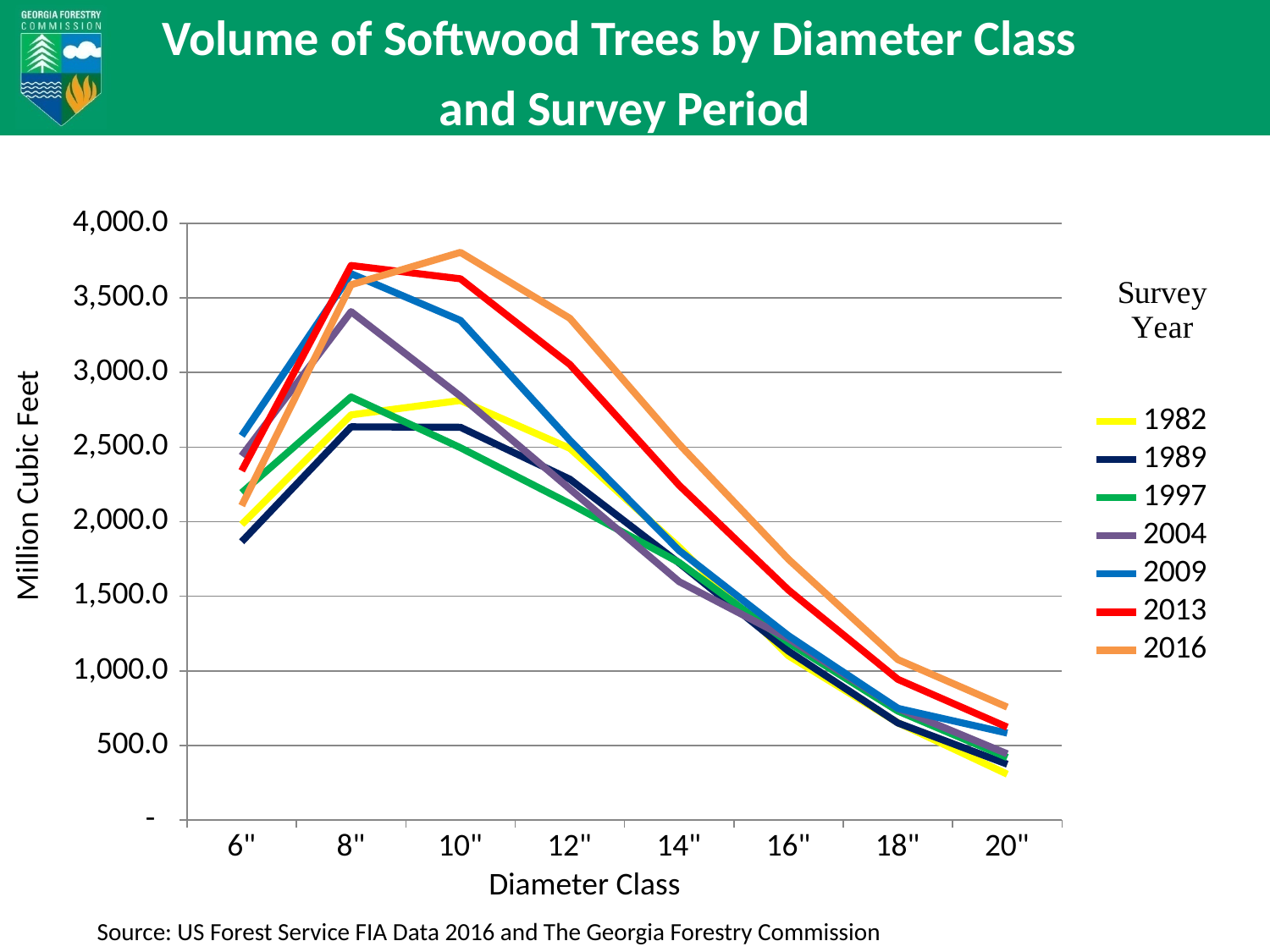
What kind of chart is shown on the slide? line chart Which survey year has the highest volume at the 10" diameter class? 2016 At the 20" diameter class, which is larger: the 2016 value or the 1982 value? 2016 Which survey year has the lowest volume at the 6" diameter class? 1989 How many diameter classes are shown on the x axis? 8 How many survey years does the legend list? 7 Is the value for the 1982 survey at the 20" diameter class greater or less than 500.0? less Is the value for the 2016 survey at the 10" diameter class greater or less than 3,500.0? greater Is the value for the 1989 survey at the 6" diameter class greater or less than 2,000.0? less Does the 2016 line rise or fall from the 10" diameter class to the 20" diameter class? fall